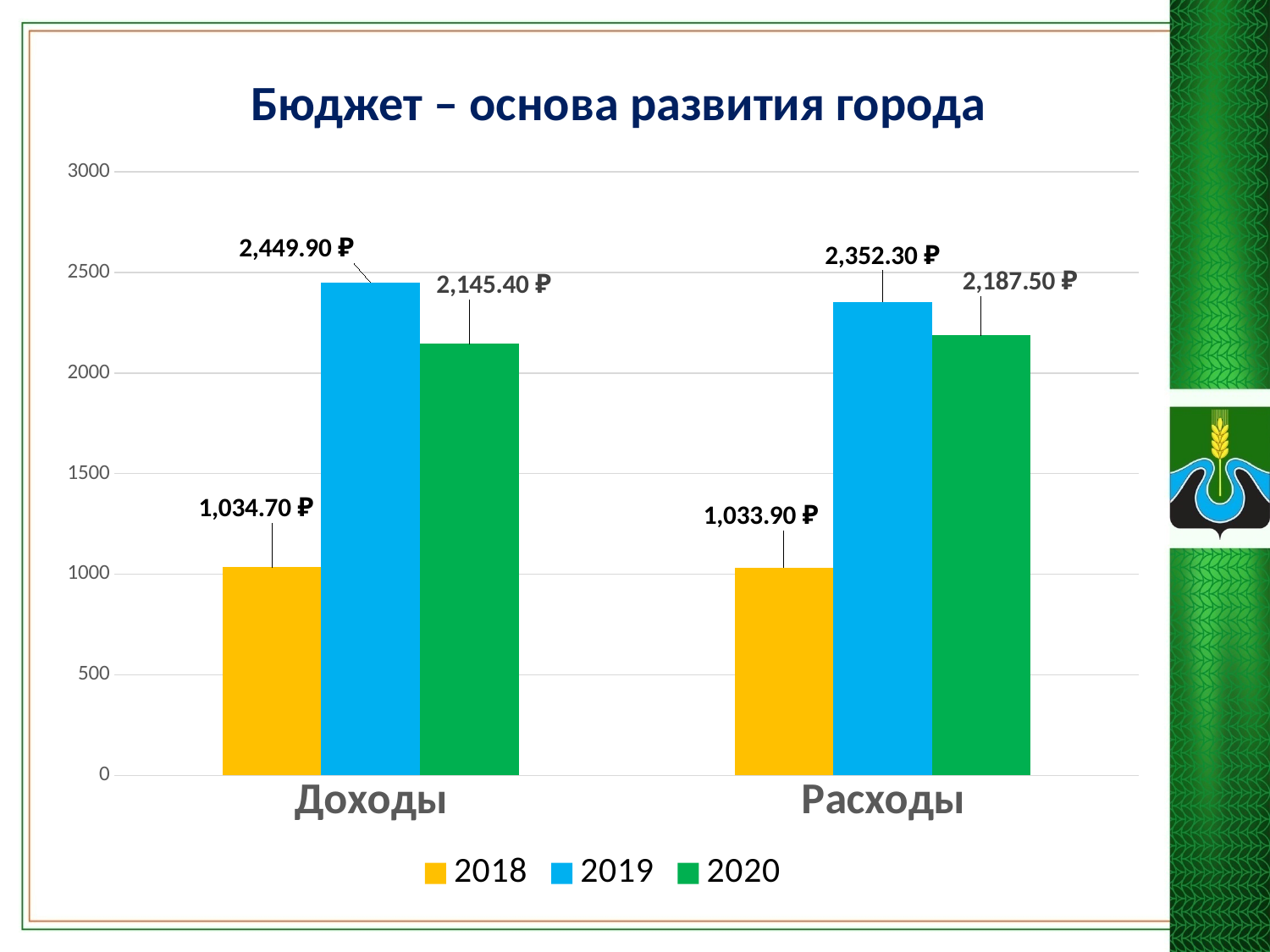
What is the difference between the 2019 and 2020 values in the Расходы category? 164.80 ₽ Which is larger: the 2019 value for Доходы or the 2019 value for Расходы? 2019 value for Доходы What is the value for 2018 in the Доходы category? 1,034.70 ₽ Which year has the lowest value in the Расходы category? 2018 What is the value for 2019 in the Расходы category? 2,352.30 ₽ What is the value for 2020 in the Расходы category? 2,187.50 ₽ How many series does the legend list? 3 What is the difference between the 2019 and 2020 values in the Доходы category? 304.50 ₽ What is the value for 2019 in the Доходы category? 2,449.90 ₽ Which year has the highest value in the Доходы category? 2019 What is the title of the chart? Бюджет – основа развития города What kind of chart is shown on the slide? Bar chart